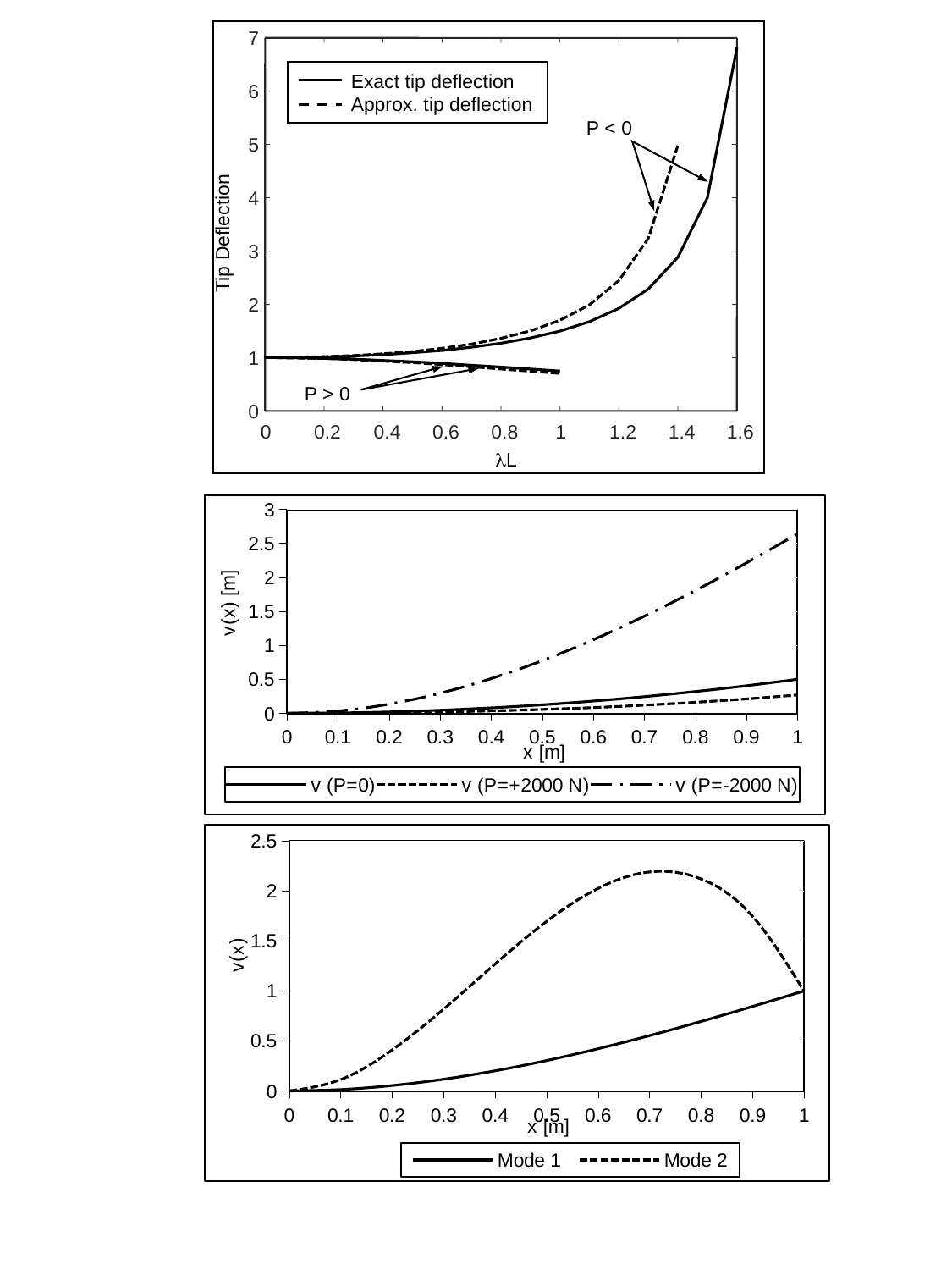
In the top chart (Tip Deflection vs λL), what is the tip deflection of both curves at λL = 0? 1 In the top chart (Tip Deflection vs λL), how many series does the legend list? 2 In the top chart (Tip Deflection vs λL), what kind of chart is it? line chart In the middle chart (v(x) [m] vs x [m]), is the value of v (P=-2000 N) at x = 1 greater or less than 2? greater In the bottom chart (Mode 1 and Mode 2), does Mode 1 rise or fall as x increases from 0 to 1? rise In the middle chart (v(x) [m] vs x [m]), at x = 1, which is larger: v (P=0) or v (P=+2000 N)? v (P=0) In the top chart (Tip Deflection vs λL), is the exact tip deflection at λL = 1.6 greater or less than 6? greater In the bottom chart (Mode 1 and Mode 2), is the peak value of Mode 2 greater or less than 2? greater In the bottom chart (Mode 1 and Mode 2), what is the x-axis label? x [m] In the middle chart (v(x) [m] vs x [m]), which series reaches the highest value at x = 1? v (P=-2000 N) In the middle chart (v(x) [m] vs x [m]), how many series does the legend list? 3